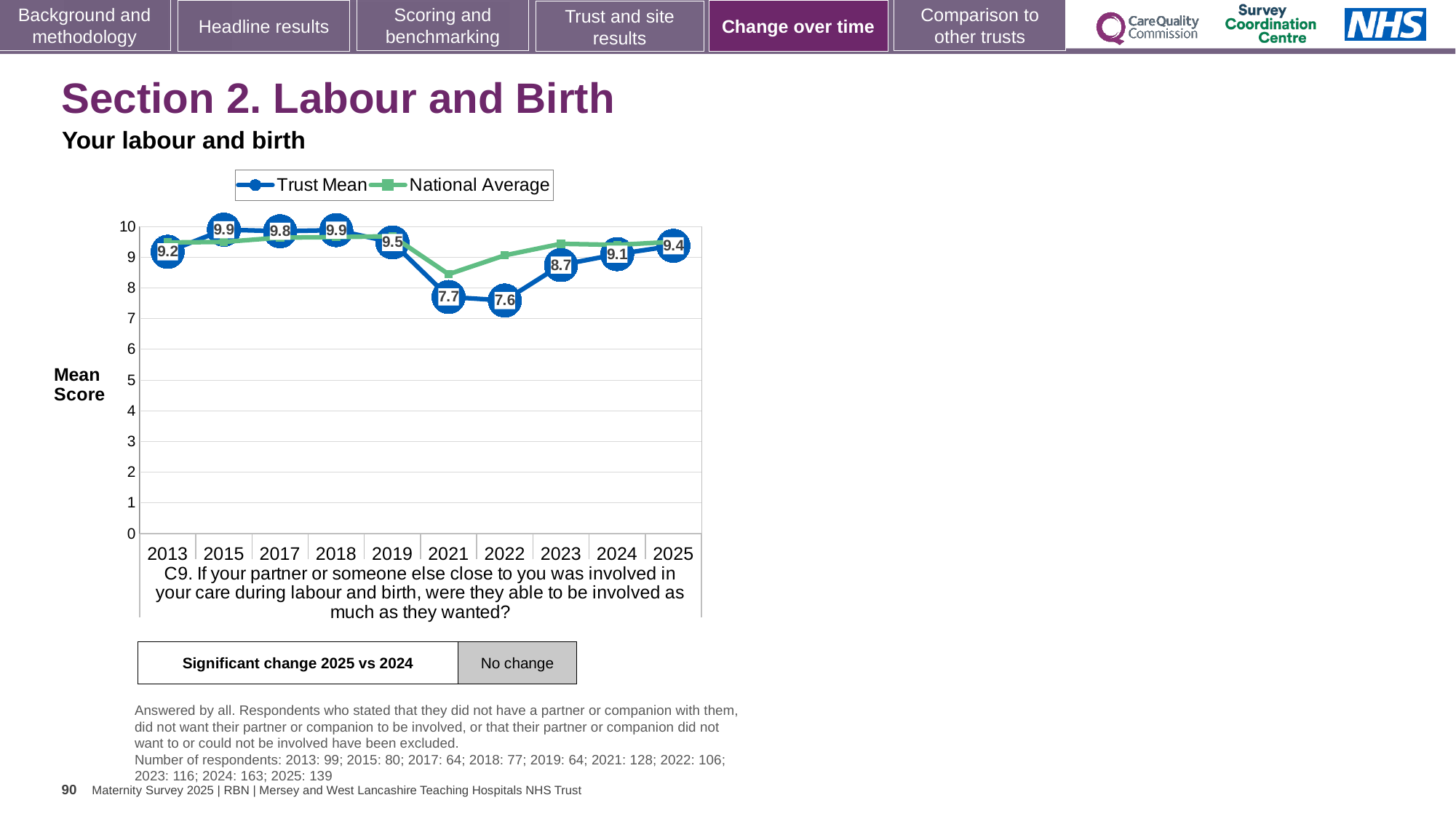
Does the Trust Mean rise or fall from 2022 to 2025? rise Is the National Average value for 2021 greater or less than 8? greater What kind of chart is shown on the slide? line chart How many years are plotted on the x axis? 10 What is the Trust Mean value for 2021? 7.7 In which year is the Trust Mean lowest? 2022 What is the difference between the Trust Mean in 2019 and in 2021? 1.8 How many series does the legend list? 2 What is the Trust Mean value for 2013? 9.2 Which year has the larger Trust Mean, 2023 or 2024? 2024 What is the Trust Mean value for 2025? 9.4 What is the difference between the Trust Mean in 2025 and in 2024? 0.3